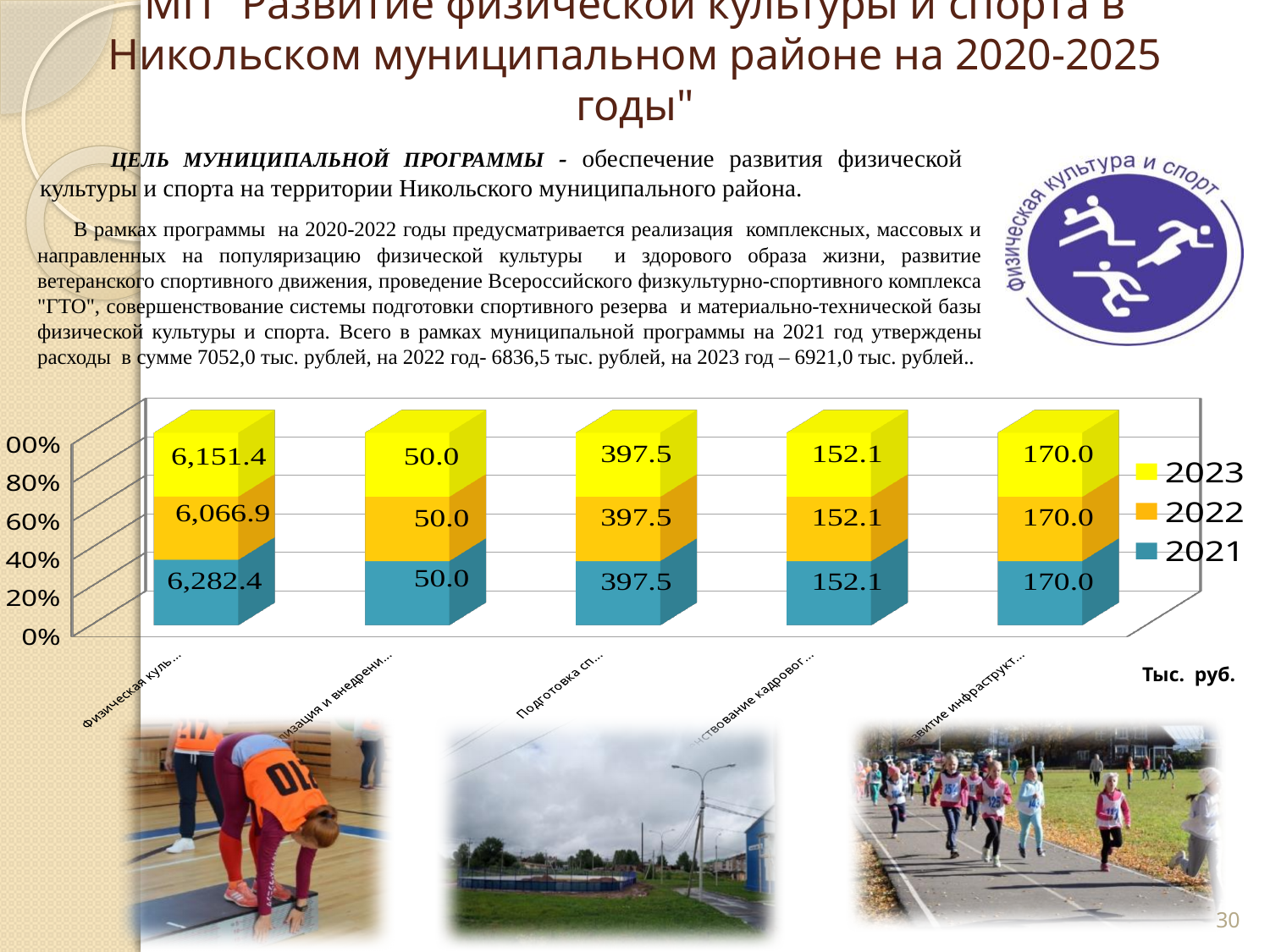
How many categories (bars) are shown in the chart? 5 What is the value for 2022 in the second bar of the chart? 50.0 What is the value for 2021 in the fifth (rightmost) bar of the chart? 170.0 In the first (leftmost) bar, which is larger: the 2021 value or the 2022 value? 2021 What is the value for 2022 in the third bar of the chart? 397.5 What is the value for 2023 in the first (leftmost) bar of the chart? 6,151.4 How many series does the chart legend list? 3 In the first (leftmost) bar, which year has the lowest value? 2022 In the first (leftmost) bar, what is the difference between the 2021 value and the 2023 value? 131.0 What is the value for 2021 in the first (leftmost) bar of the chart? 6,282.4 What unit label is shown below the chart on the right? Тыс. руб. What kind of chart is shown on the slide? Stacked bar chart